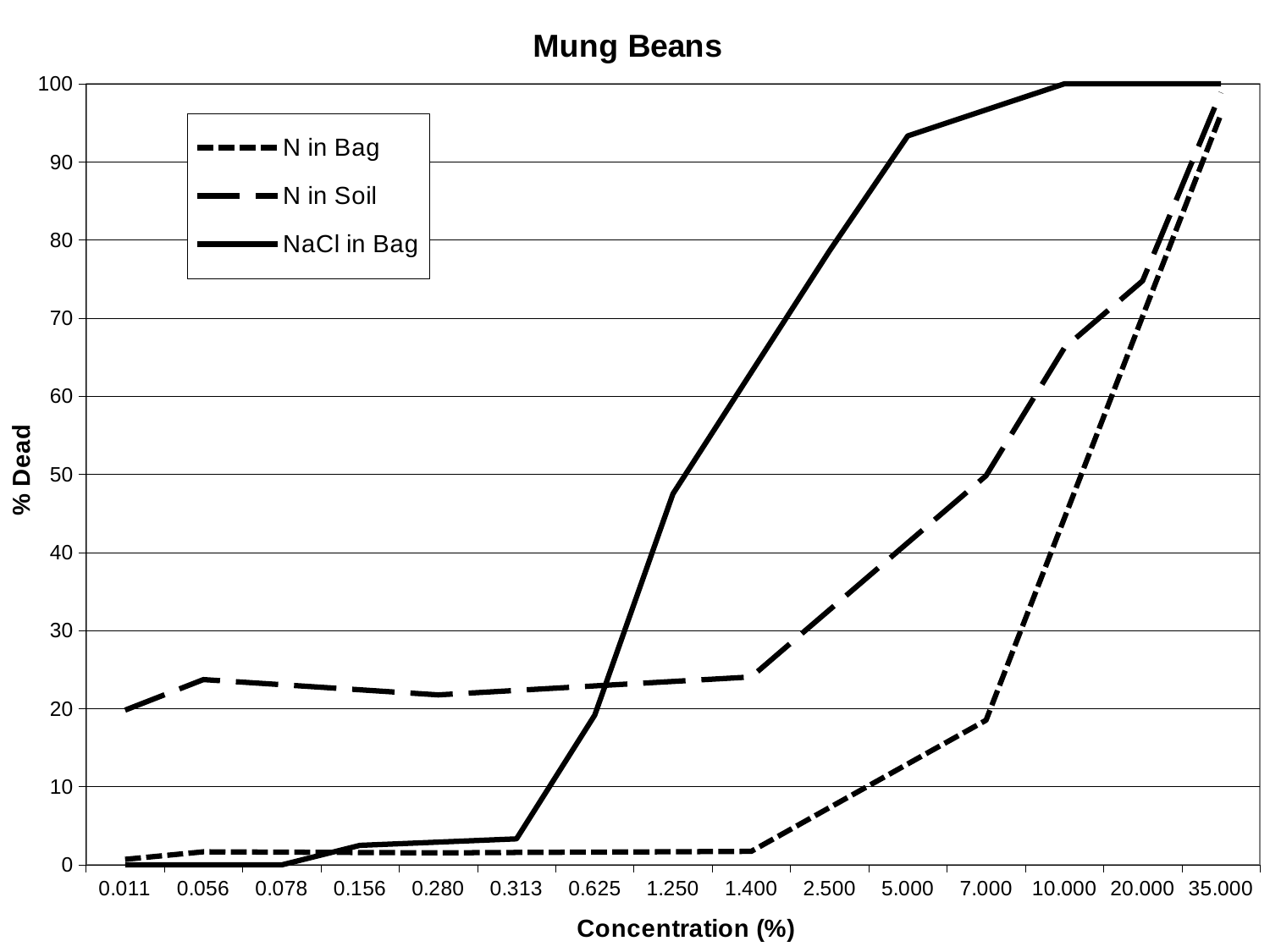
Is the value for NaCl in Bag at a concentration of 5.000 greater or less than 90? greater What type of chart is shown on the slide? line chart What is the % Dead value for NaCl in Bag at a concentration of 0.011? 0 At a concentration of 5.000, which series has the higher % Dead: NaCl in Bag or N in Soil? NaCl in Bag How many concentration values are shown along the x axis? 15 What is the label of the y axis? % Dead How many series does the legend list? 3 Is the value for N in Bag at a concentration of 7.000 greater or less than 20? less Do the % Dead values for NaCl in Bag generally rise or fall as concentration increases along the x axis? rise What is the % Dead value for NaCl in Bag at a concentration of 10.000? 100 Is the value for N in Soil at a concentration of 1.250 greater or less than 30? less What is the title of the chart? Mung Beans